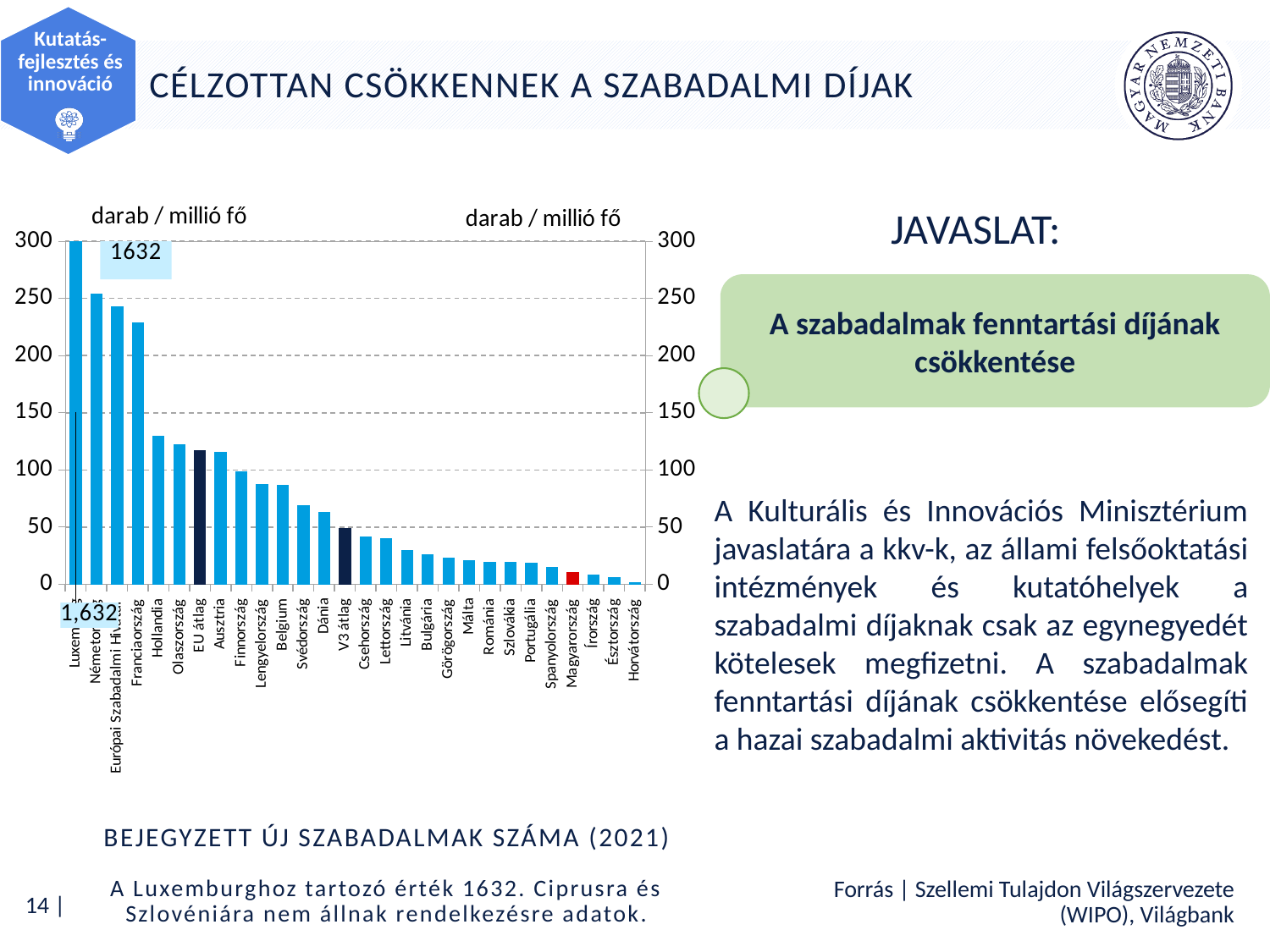
Which has a larger value, Németország or Franciaország? Németország Which country has the highest value in the chart? Luxemburg Is the value for Franciaország greater or less than 250? less Which country has the lowest value in the chart? Horvátország Is the value for Hollandia greater or less than 100? greater Is the value for Németország greater or less than 200? greater Which has a larger value, Ausztria or Magyarország? Ausztria What is the value for Luxemburg in the chart? 1632 Which country's bar is coloured red in the chart? Magyarország Do the values rise or fall from left to right along the x axis? fall What kind of chart is shown on the slide? bar chart